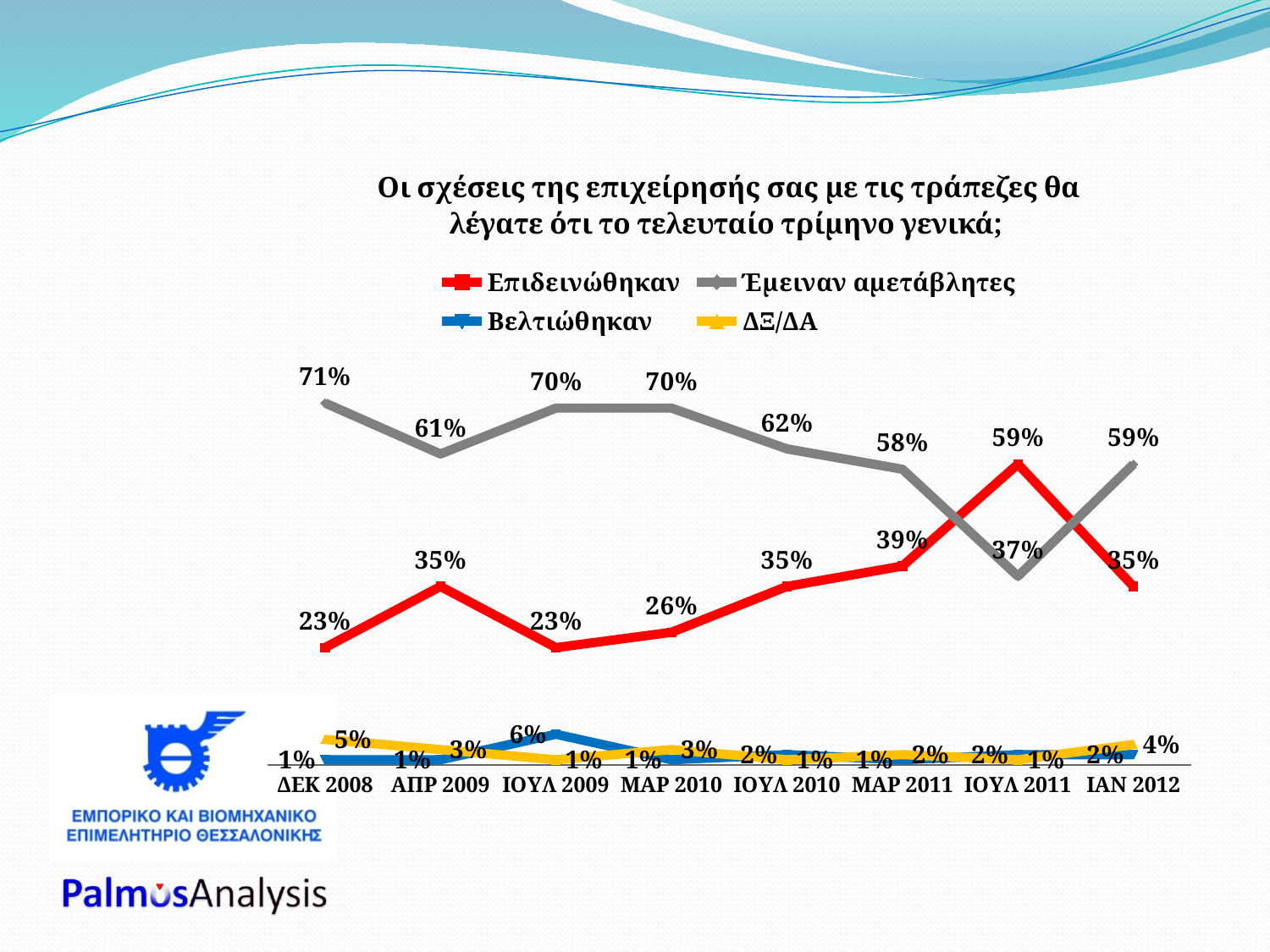
What is the value of the Έμειναν αμετάβλητες series at ΔΕΚ 2008? 71% At ΙΟΥΛ 2011, which series has the larger value: Επιδεινώθηκαν or Έμειναν αμετάβλητες? Επιδεινώθηκαν How many time points are shown on the x axis? 8 What kind of chart is shown on the slide? Line chart What is the value of the Επιδεινώθηκαν series at ΙΟΥΛ 2011? 59% At which time point does the Επιδεινώθηκαν series reach its highest value? ΙΟΥΛ 2011 What colour is used for the Έμειναν αμετάβλητες series? Gray What is the difference between the Έμειναν αμετάβλητες and Επιδεινώθηκαν values at ΔΕΚ 2008? 48 percentage points How many series does the legend list? 4 At which time point does the Έμειναν αμετάβλητες series reach its lowest value? ΙΟΥΛ 2011 Does the Έμειναν αμετάβλητες series rise or fall from ΙΟΥΛ 2009 to ΙΟΥΛ 2011? Fall What is the value of the Βελτιώθηκαν series at ΙΟΥΛ 2009? 6%